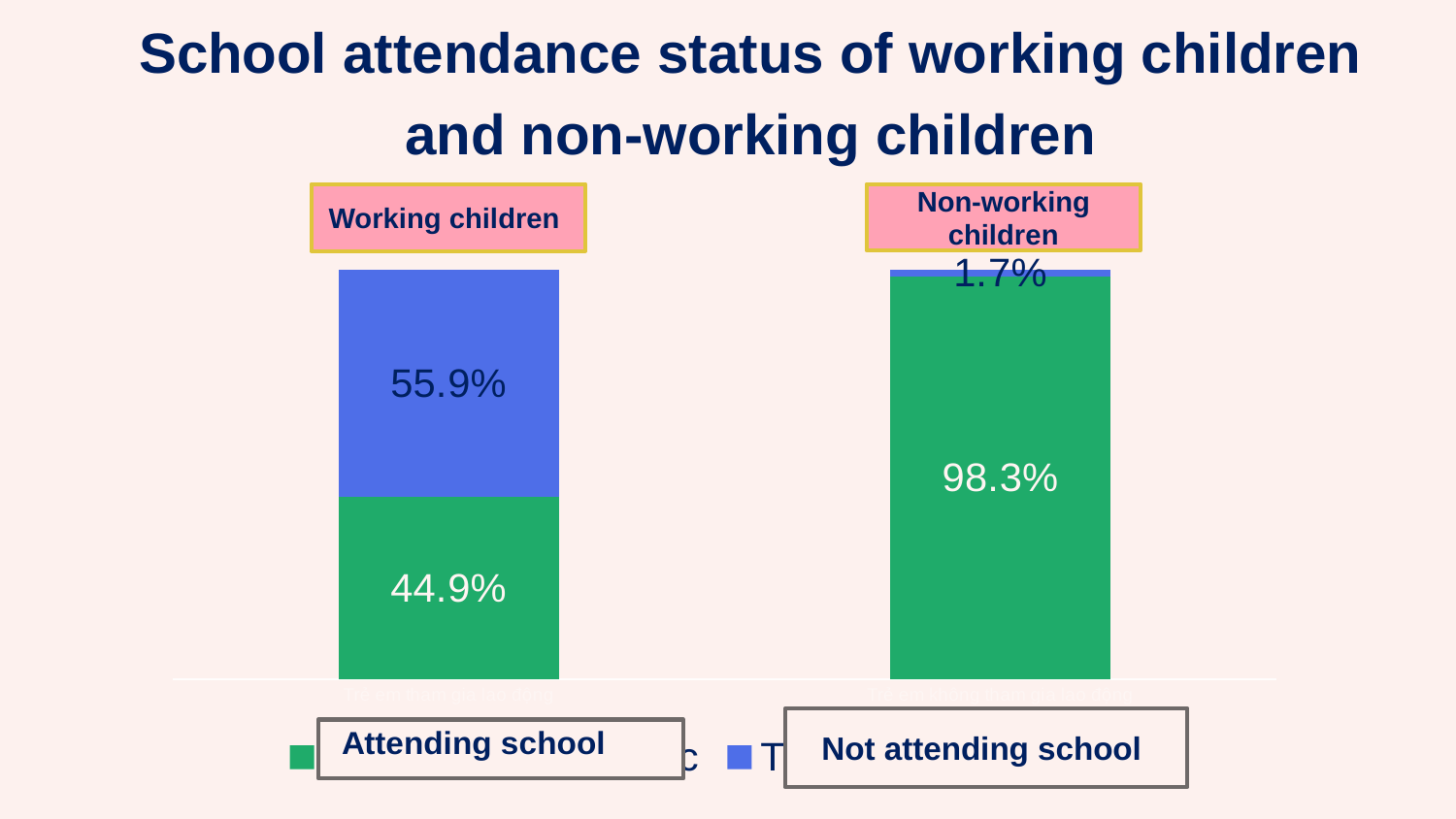
How many series does the legend list? 2 What percentage of non-working children are not attending school? 1.7% What type of chart is shown on the slide? Stacked bar chart How many percentage points higher is the attending-school share for non-working children than for working children? 53.4 percentage points How many percentage points higher is the not-attending-school share for working children than for non-working children? 54.2 percentage points Which group has the higher share of children attending school? Non-working children Is the share of working children attending school larger or smaller than the share of working children not attending school? Smaller What percentage of working children are attending school? 44.9% What percentage of non-working children are attending school? 98.3% Which group has the lower share of children not attending school? Non-working children How many groups of children are compared in the chart? 2 What percentage of working children are not attending school? 55.9%